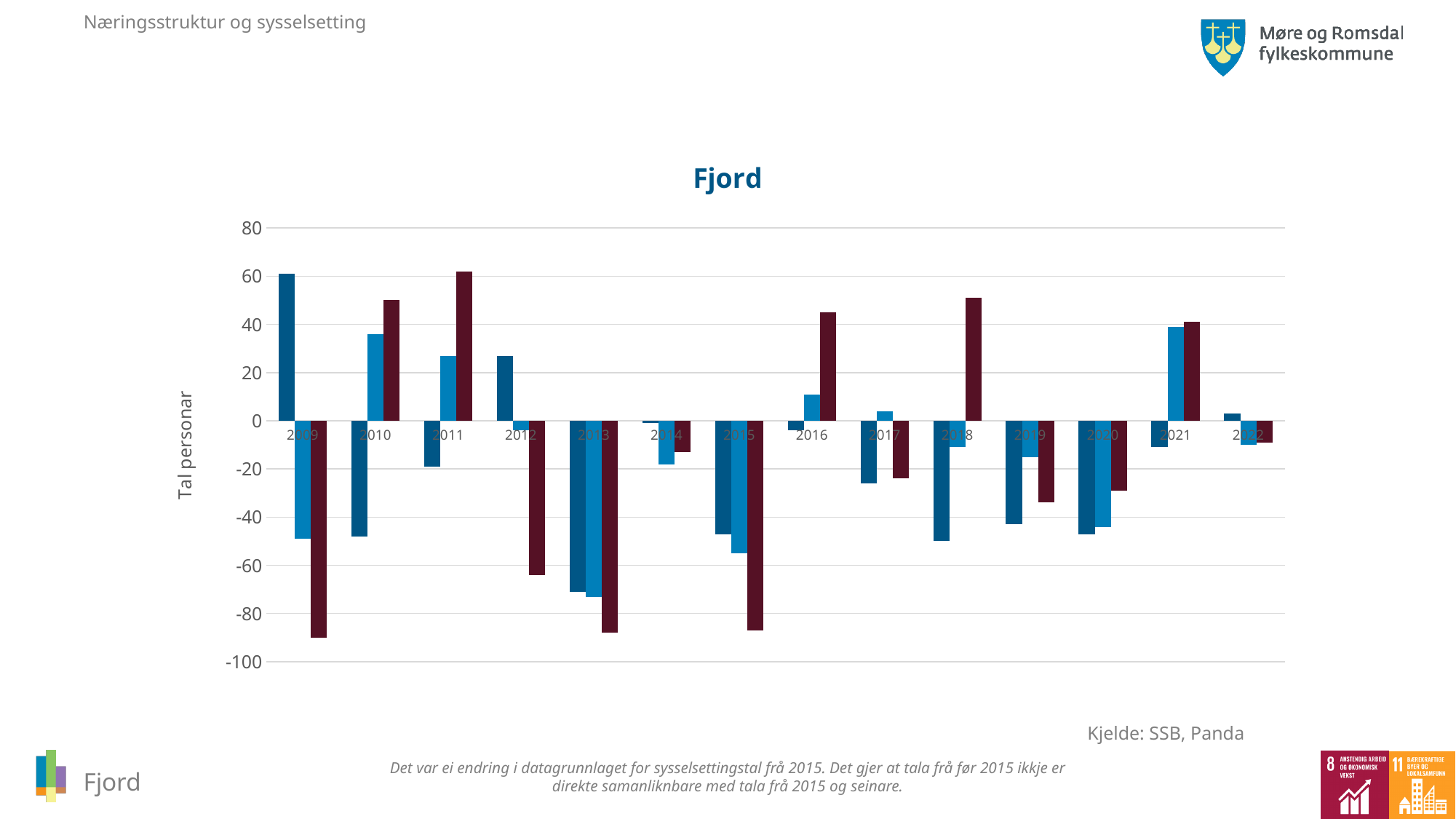
In which year does the dark blue series reach its lowest value? 2013 How many years are shown along the x axis of the chart? 14 Is the value of the dark blue bar for 2009 greater or less than 40? greater How many bars (series) are plotted for each year in the chart? 3 Is the value of the light blue bar for 2021 greater or less than 20? greater Is the value of the dark red bar for 2009 greater or less than -80? less In which year does the dark red series reach its highest value? 2011 What is the label on the vertical axis of the chart? Tal personar What is the title of the chart? Fjord For 2010, which is larger: the dark blue bar or the light blue bar? The light blue bar What type of chart is shown on the slide? Bar chart